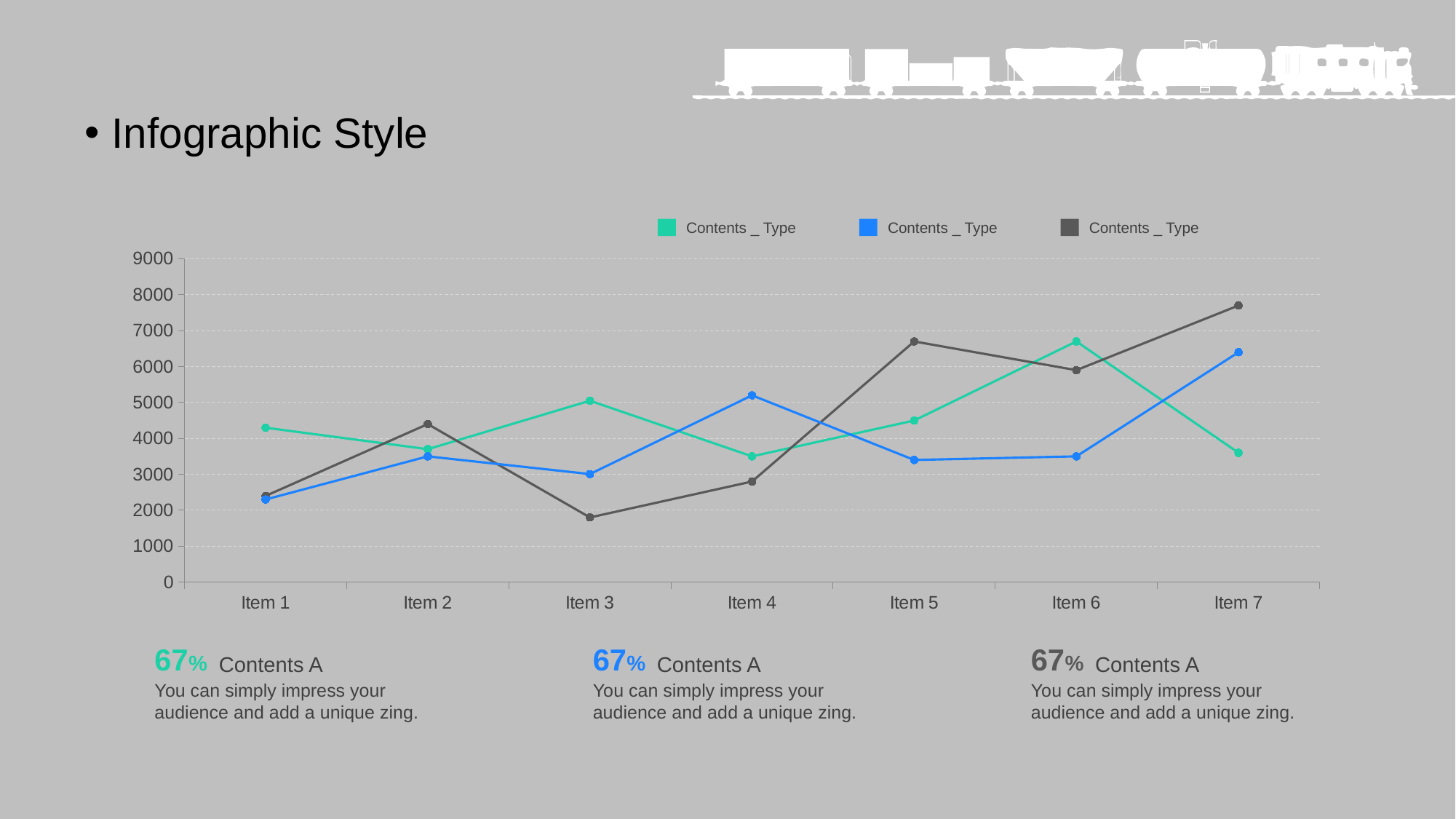
Is the value of the dark gray series for Item 3 greater or less than 2000? less At which item does the dark gray series reach its lowest value? Item 3 At which item does the dark gray series reach its highest value? Item 7 At which item does the green series reach its highest value? Item 6 At Item 3, which series has the larger value, the green series or the dark gray series? the green series Is the value of the green series for Item 6 greater or less than 6000? greater Is the value of the blue series for Item 7 greater or less than 6000? greater How many categories are shown on the x axis of the chart? 7 What is the highest value shown on the chart's vertical axis? 9000 How many series does the chart's legend list? 3 What kind of chart is shown on the slide? line chart